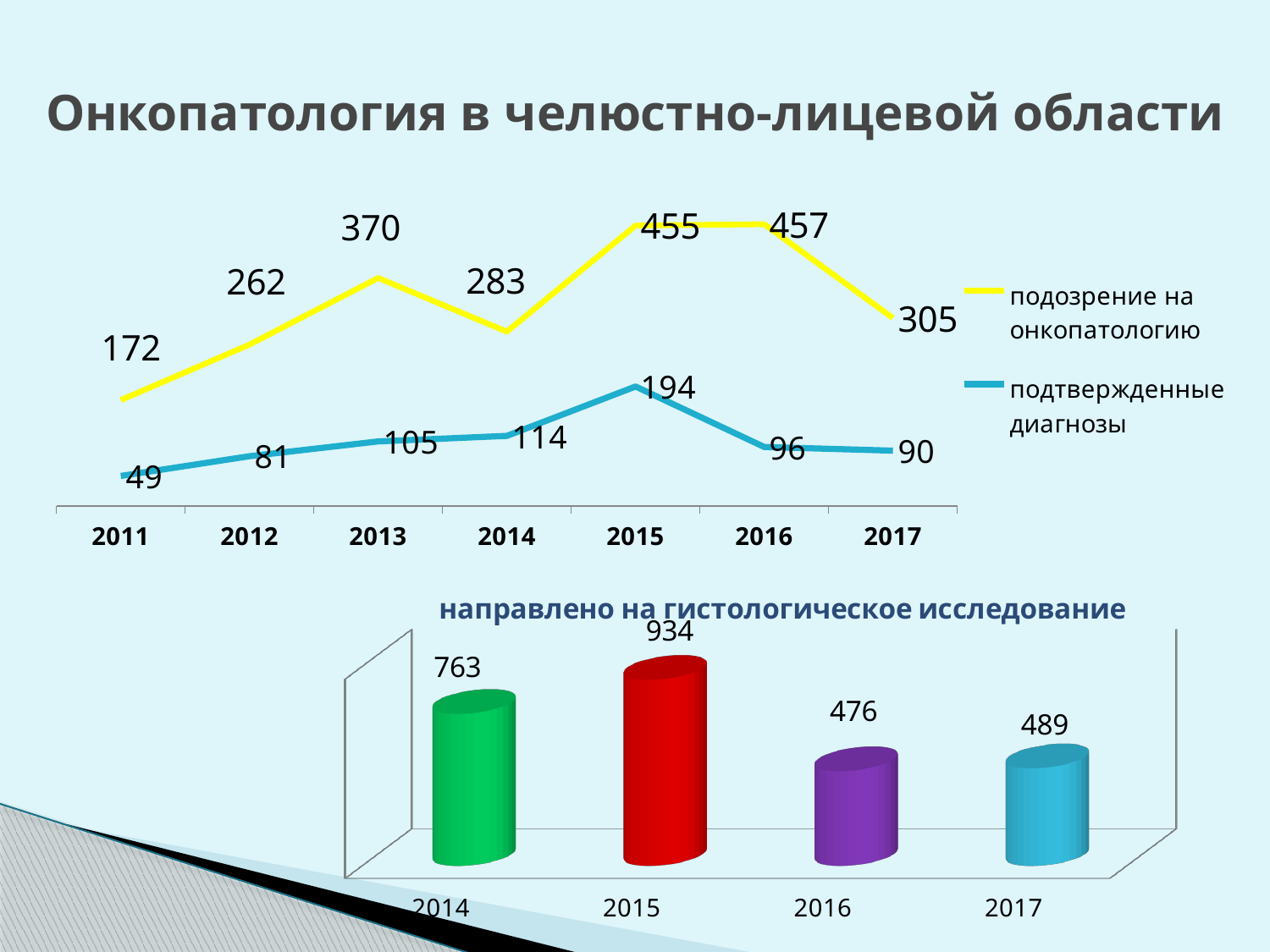
In the bottom chart 'направлено на гистологическое исследование', what is the difference between 2014 and 2017? 274 In the top line chart, how many series does the legend list? 2 In the top line chart, what is the value for 'подозрение на онкопатологию' in 2013? 370 In the top line chart, does 'подтвержденные диагнозы' rise or fall from 2015 to 2017? fall In the bottom chart 'направлено на гистологическое исследование', what is the value for 2015? 934 What kind of chart is the bottom chart 'направлено на гистологическое исследование'? bar chart In the top line chart, what is the difference between 'подозрение на онкопатологию' and 'подтвержденные диагнозы' in 2017? 215 In the top line chart, how many years are shown on the x axis? 7 In the top line chart, which year has the highest value for 'подозрение на онкопатологию'? 2016 In the bottom chart 'направлено на гистологическое исследование', which year has the lowest value? 2016 In the top line chart, what is the value for 'подтвержденные диагнозы' in 2015? 194 In the top line chart, which year has the lowest value for 'подтвержденные диагнозы'? 2011